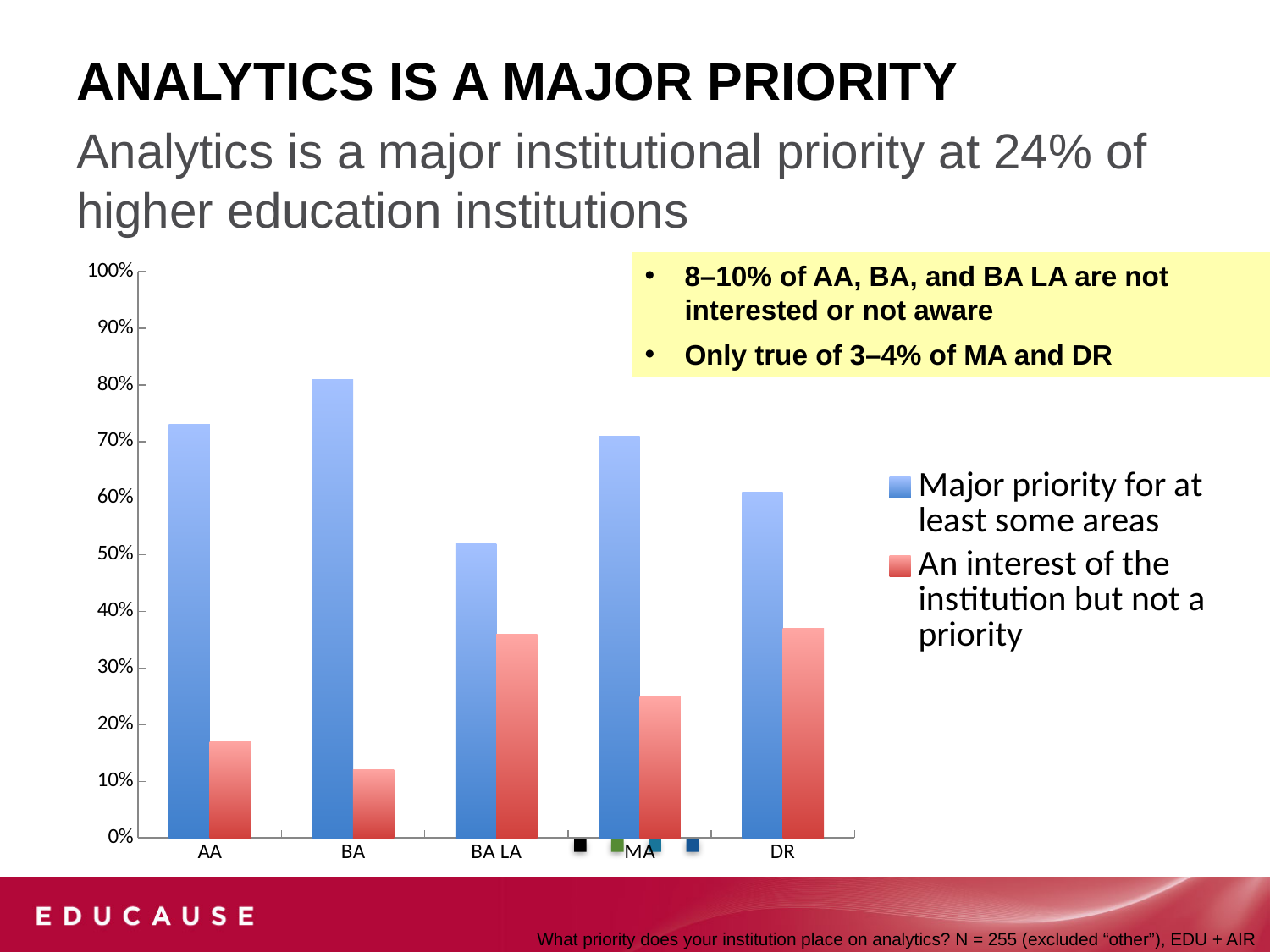
Which category has the lowest value for 'An interest of the institution but not a priority'? BA Is the value for 'An interest of the institution but not a priority' at BA greater or less than 20%? less Which category has the highest value for 'Major priority for at least some areas'? BA How many categories are shown on the x axis of the chart? 5 Which series is shown in red in the chart? An interest of the institution but not a priority Is the value for 'Major priority for at least some areas' at BA LA greater or less than 60%? less Is the value for 'Major priority for at least some areas' at BA greater or less than 70%? greater Which category has the lowest value for 'Major priority for at least some areas'? BA LA Which is larger for 'Major priority for at least some areas': BA LA or DR? DR What kind of chart is shown on the slide? bar chart How many series does the chart legend list? 2